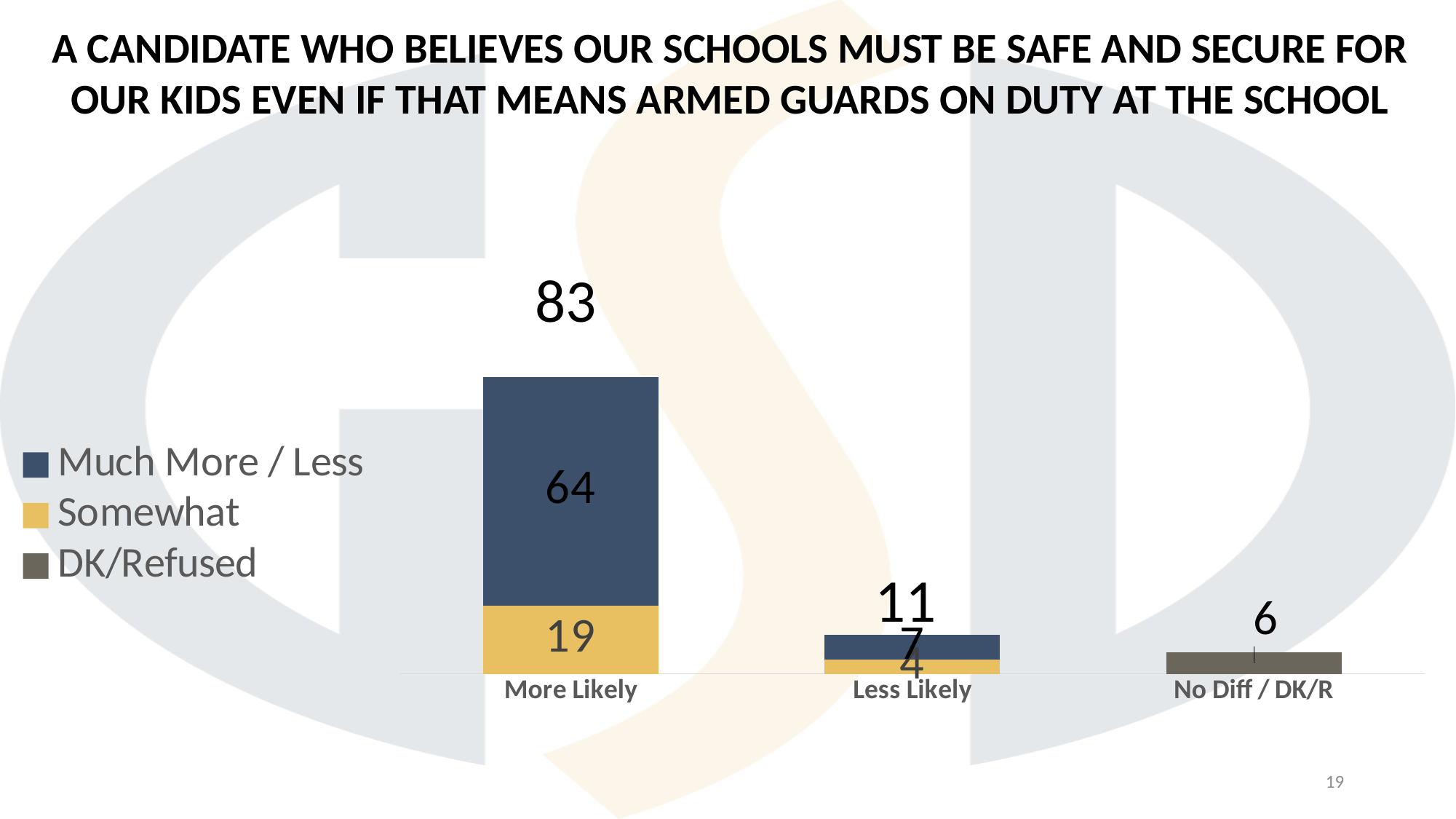
Which category has the highest total? More Likely What is the value for No Diff / DK/R? 6 What is the Much More / Less value for More Likely? 64 Which is larger: the Somewhat value for More Likely or the total for Less Likely? Somewhat value for More Likely What is the Somewhat value for More Likely? 19 What kind of chart is shown? Stacked bar chart What is the Much More / Less value for Less Likely? 7 What is the difference between the Much More / Less value and the Somewhat value for More Likely? 45 What is the total of the stacked bar for Less Likely? 11 What is the Somewhat value for Less Likely? 4 How many series does the legend list? 3 What is the total of the stacked bar for More Likely? 83